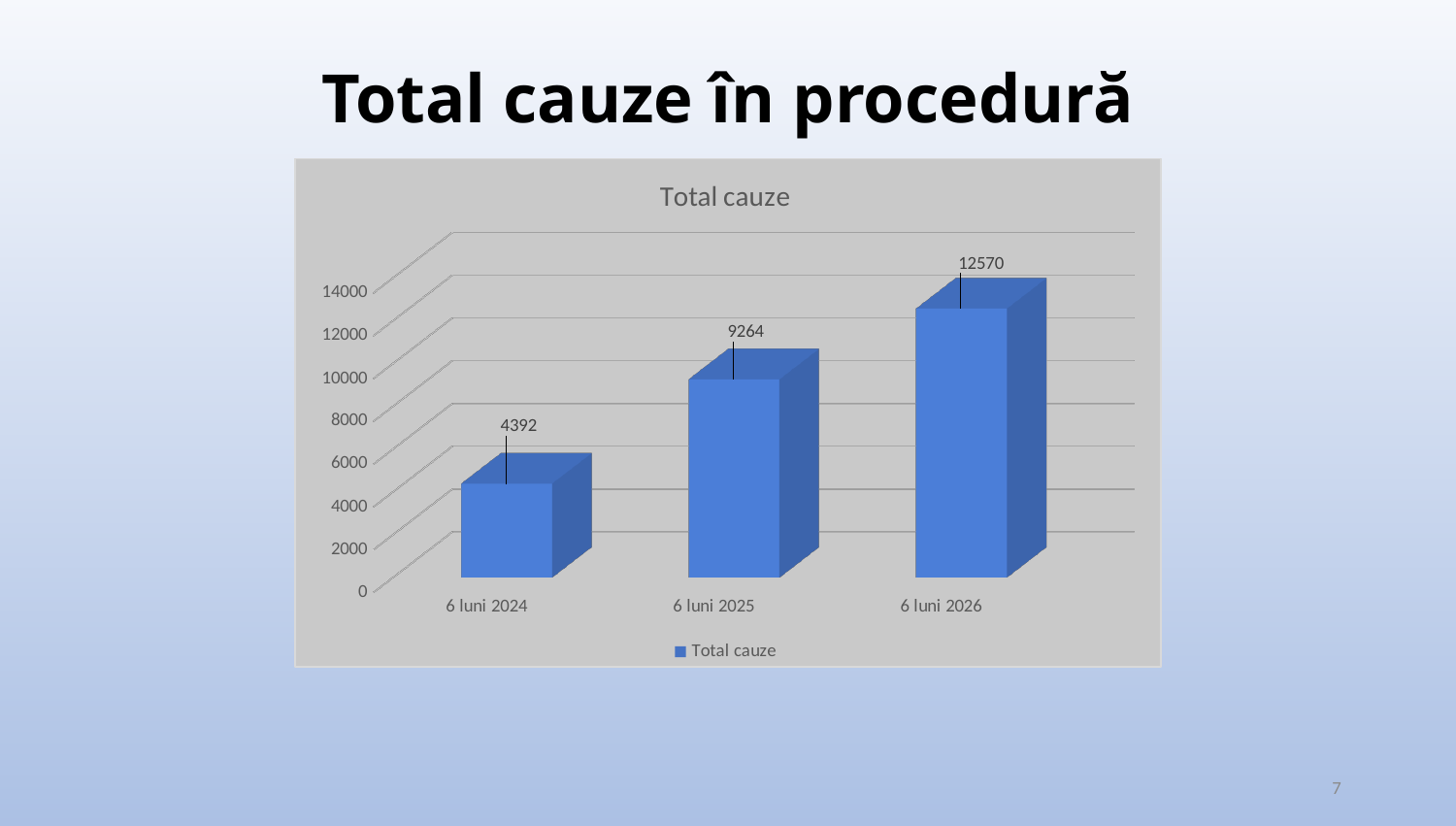
Which category has the lowest value? 6 luni 2024 Do the values rise or fall from 6 luni 2024 to 6 luni 2026? rise What is the value for 6 luni 2025? 9264 What kind of chart is shown on the slide? bar chart How many categories are shown on the x axis? 3 What is the value for 6 luni 2024? 4392 Which category has the highest value? 6 luni 2026 What is the value for 6 luni 2026? 12570 How many series does the legend list? 1 What is the difference between the values for 6 luni 2026 and 6 luni 2025? 3306 What is the difference between the values for 6 luni 2025 and 6 luni 2024? 4872 Which is larger, the value for 6 luni 2024 or the value for 6 luni 2025? 6 luni 2025